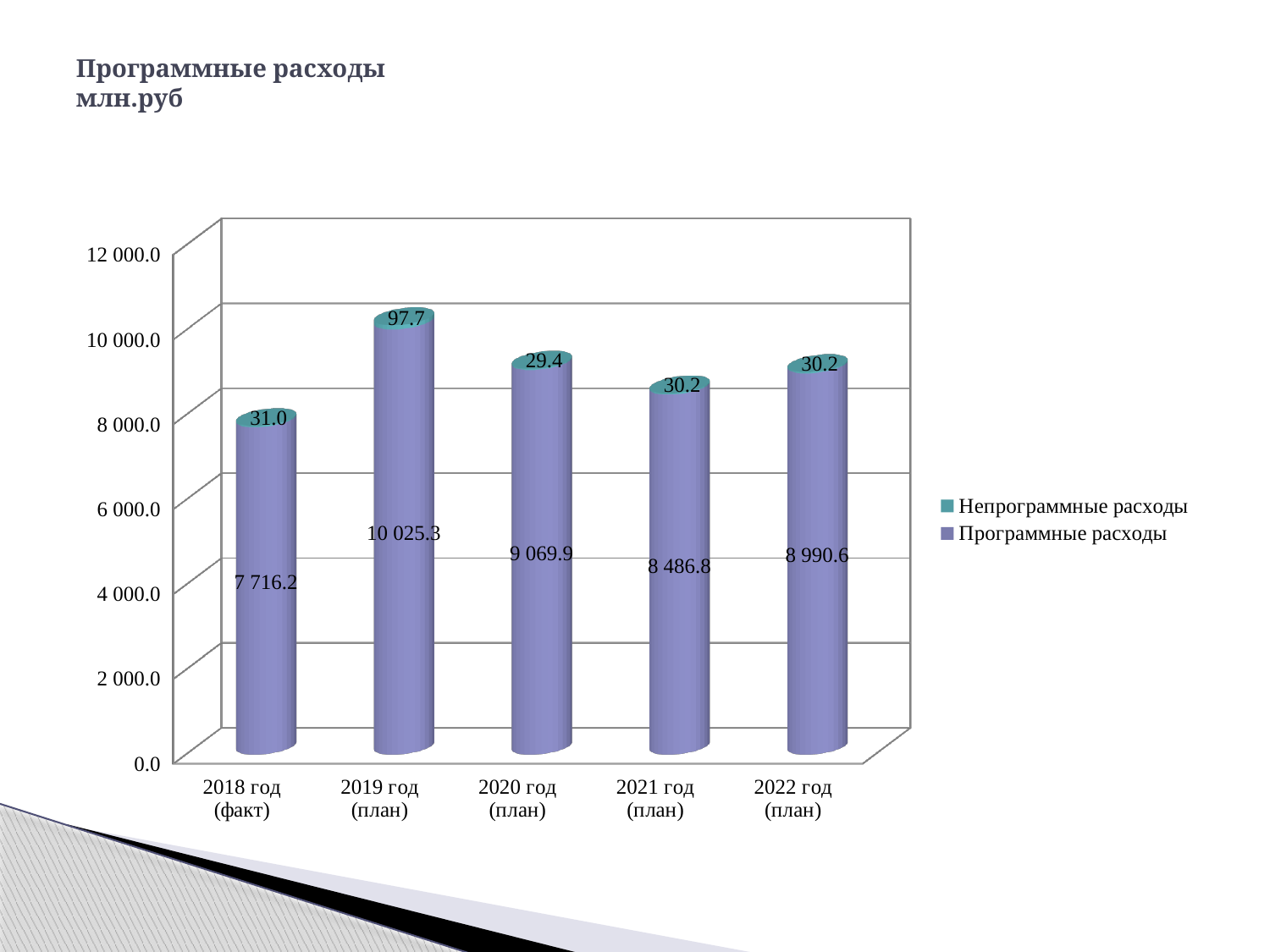
Which is larger: Программные расходы for 2020 год (план) or for 2021 год (план)? 2020 год (план) What is the value of Непрограммные расходы for 2019 год (план)? 97.7 What is the value of Программные расходы for 2022 год (план)? 8 990.6 How many year categories are shown on the x axis? 5 What is the value of Программные расходы for 2018 год (факт)? 7 716.2 What is the difference in Программные расходы between 2019 год (план) and 2018 год (факт)? 2 309.1 How many series does the legend list? 2 What kind of chart is shown on the slide? Stacked bar chart What is the total of the stacked bar for 2021 год (план)? 8 517.0 What is the difference in Непрограммные расходы between 2019 год (план) and 2018 год (факт)? 66.7 Which year has the highest value of Программные расходы? 2019 год (план) Which year has the lowest value of Программные расходы? 2018 год (факт)